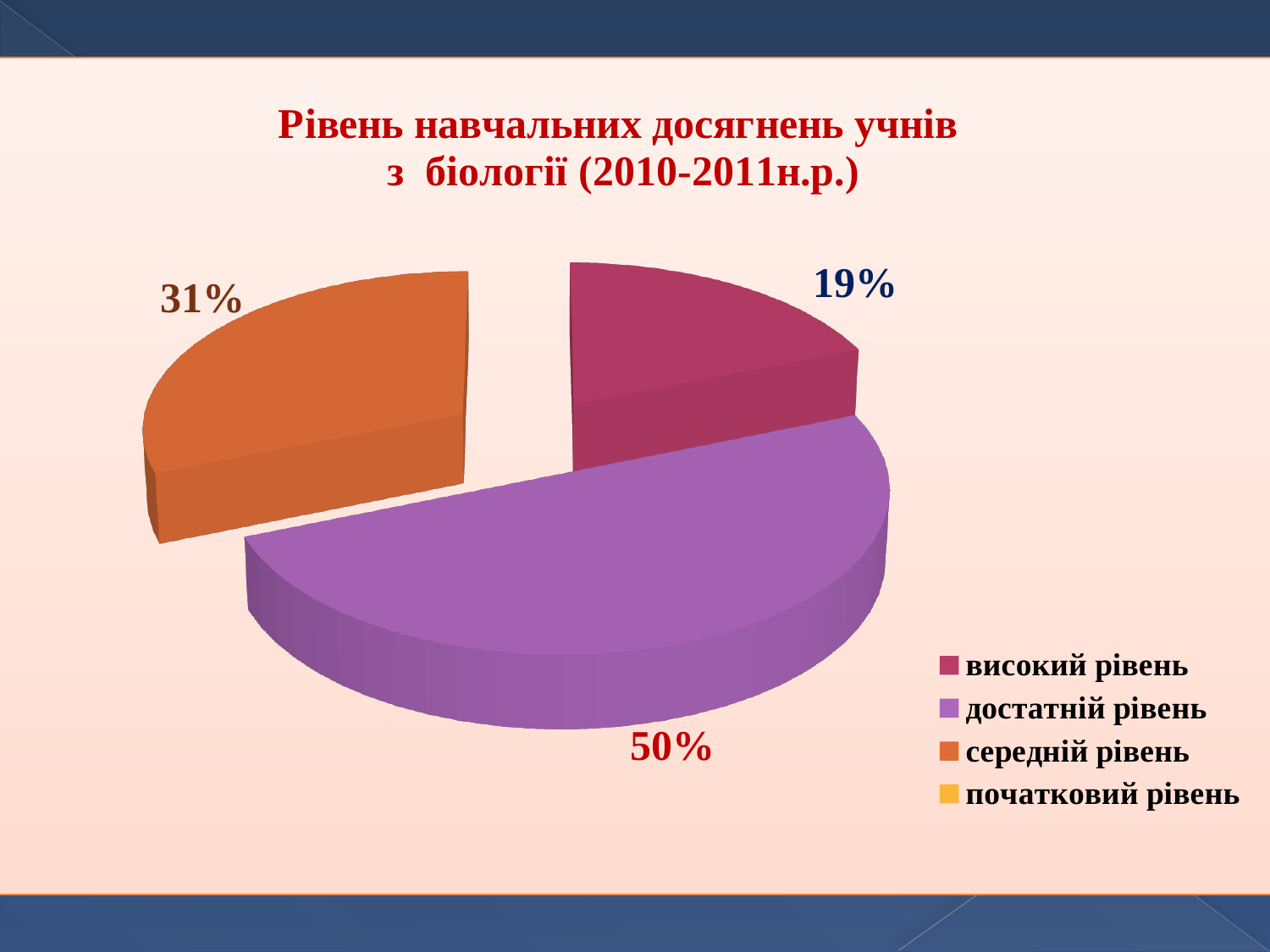
Which is larger: the share of "середній рівень" or the share of "високий рівень"? середній рівень What kind of chart is shown on the slide? pie chart Which of the labelled slices is the smallest? високий рівень How many entries does the legend list? 4 What is the title of the chart? Рівень навчальних досягнень учнів з біології (2010-2011н.р.) What share of the pie does "достатній рівень" have? 50% Which category has the largest slice of the pie? достатній рівень How many slices with data labels are visible in the pie? 3 What colour is the slice for "середній рівень"? orange What is the difference between the shares of "середній рівень" and "високий рівень"? 12% What share of the pie does "середній рівень" have? 31% What share of the pie does "високий рівень" have? 19%